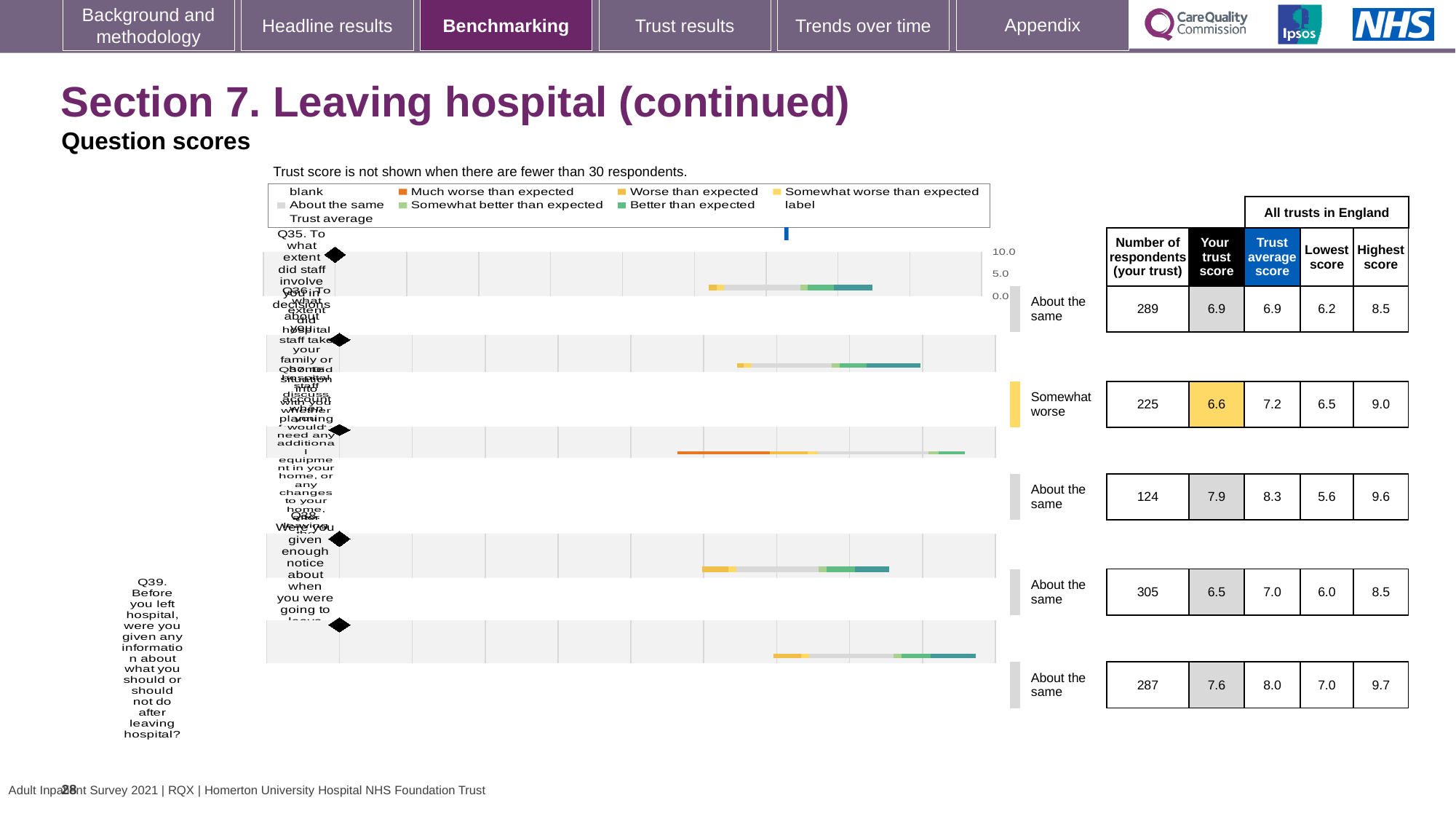
What is the highest 'Your trust score' value shown in the table? 7.9 What kind of chart is used to show the question scores? Bar chart Which question is rated 'Somewhat worse' than expected? Q36 What is the lowest score across all trusts in England for Q35? 6.2 What is the smallest number of respondents shown in the table? 124 How many questions are shown in the chart and table on this slide? 5 What is the 'Your trust score' for Q35 (To what extent did staff involve you in decisions about you leaving hospital)? 6.9 What is the lowest score across all trusts in England for Q38 (Were you given enough notice about when you were going to leave)? 6.0 For Q36, how much higher is the trust average score than your trust score? 0.6 How many respondents does the table show for Q39 (Before you left hospital, were you given any information about what you should or should not do after leaving hospital)? 287 For Q39, which is larger: your trust score or the trust average score? Trust average score What is the highest score across all trusts in England for Q36? 9.0